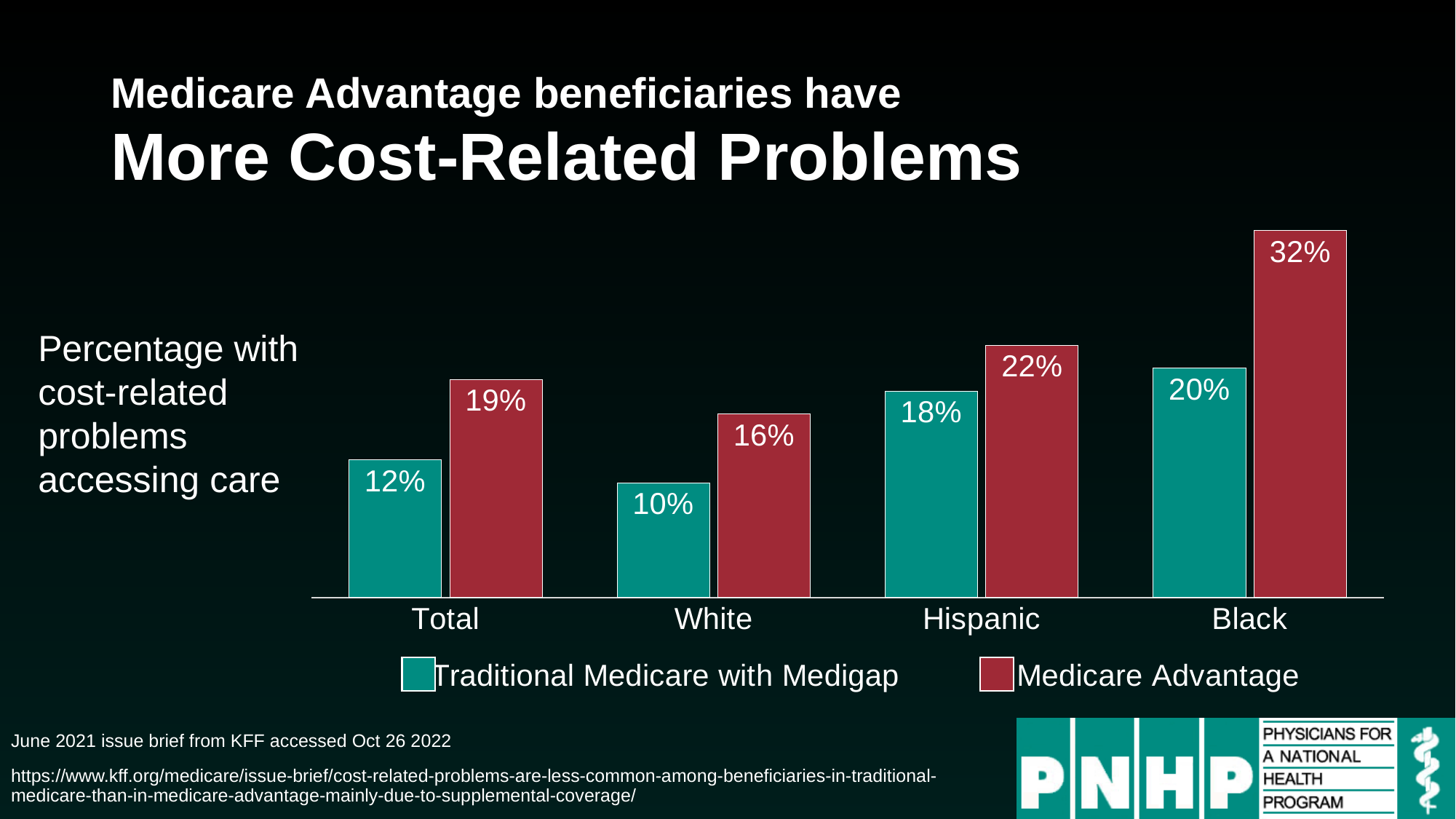
What is the Medicare Advantage value for the Total category? 19% Which category has the highest Medicare Advantage value? Black Which colour represents Medicare Advantage in the legend? Red What is the Traditional Medicare with Medigap value for Hispanic beneficiaries? 18% How many series does the legend list? 2 How many categories are shown on the x axis? 4 Which is larger for Hispanic beneficiaries: the Medicare Advantage value or the Traditional Medicare with Medigap value? Medicare Advantage Which category has the lowest Traditional Medicare with Medigap value? White What is the difference between the Medicare Advantage and Traditional Medicare with Medigap values for Black beneficiaries? 12% What kind of chart is shown on the slide? Bar chart What is the Medicare Advantage value for Black beneficiaries? 32% What is the Traditional Medicare with Medigap value for White beneficiaries? 10%